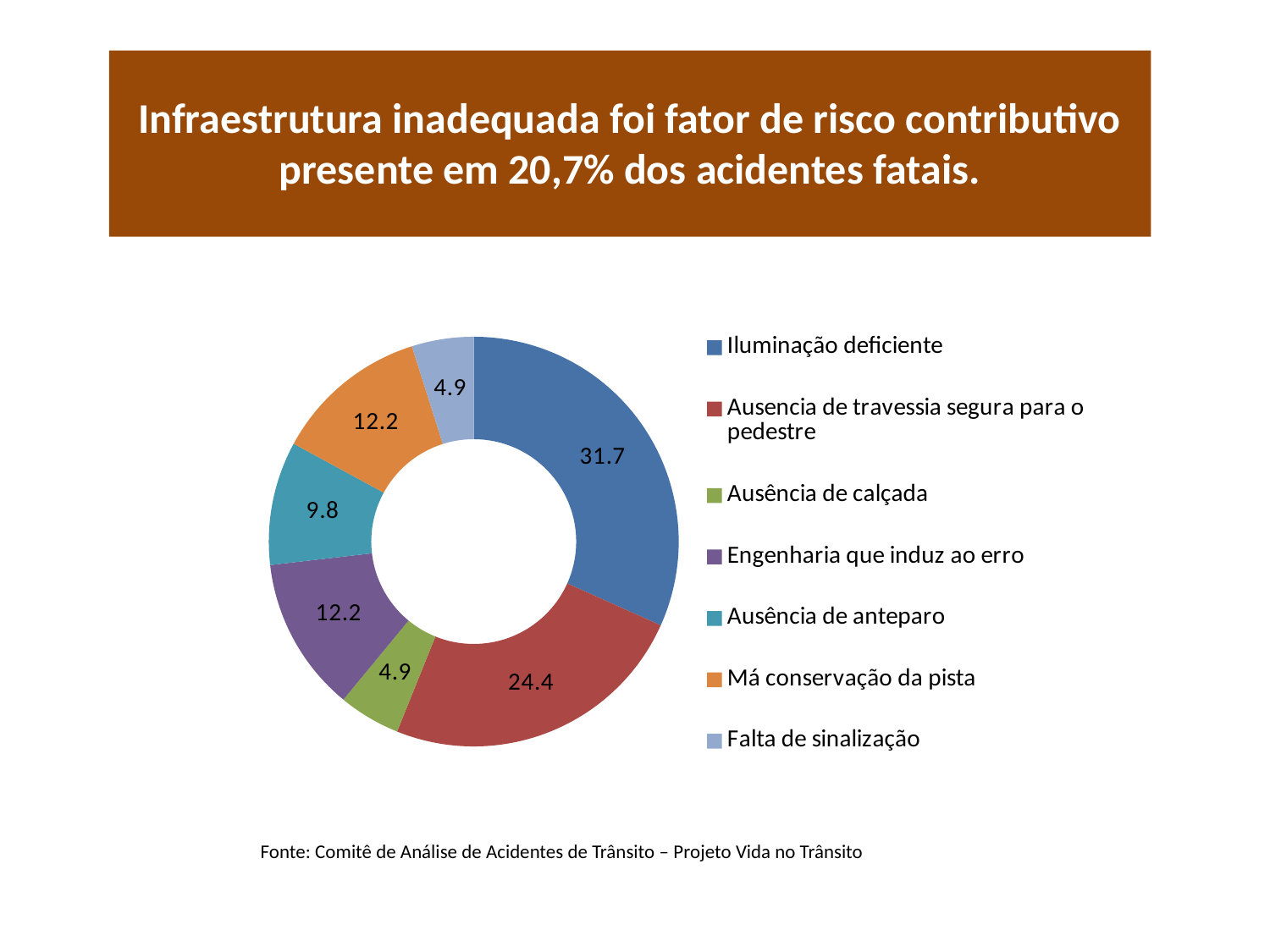
Which category is shown in green? Ausência de calçada What value is shown for Falta de sinalização? 4.9 What source is cited below the chart? Comitê de Análise de Acidentes de Trânsito – Projeto Vida no Trânsito What kind of chart is shown on the slide? Doughnut (pie) chart Which category has the largest slice? Iluminação deficiente Which is larger, Engenharia que induz ao erro or Ausência de anteparo? Engenharia que induz ao erro What is the difference between the values for Iluminação deficiente and Ausencia de travessia segura para o pedestre? 7.3 What value is shown for Ausência de anteparo? 9.8 How many categories does the chart show? 7 What value is shown for Má conservação da pista? 12.2 What value is shown for Ausencia de travessia segura para o pedestre? 24.4 What value is shown for Iluminação deficiente? 31.7